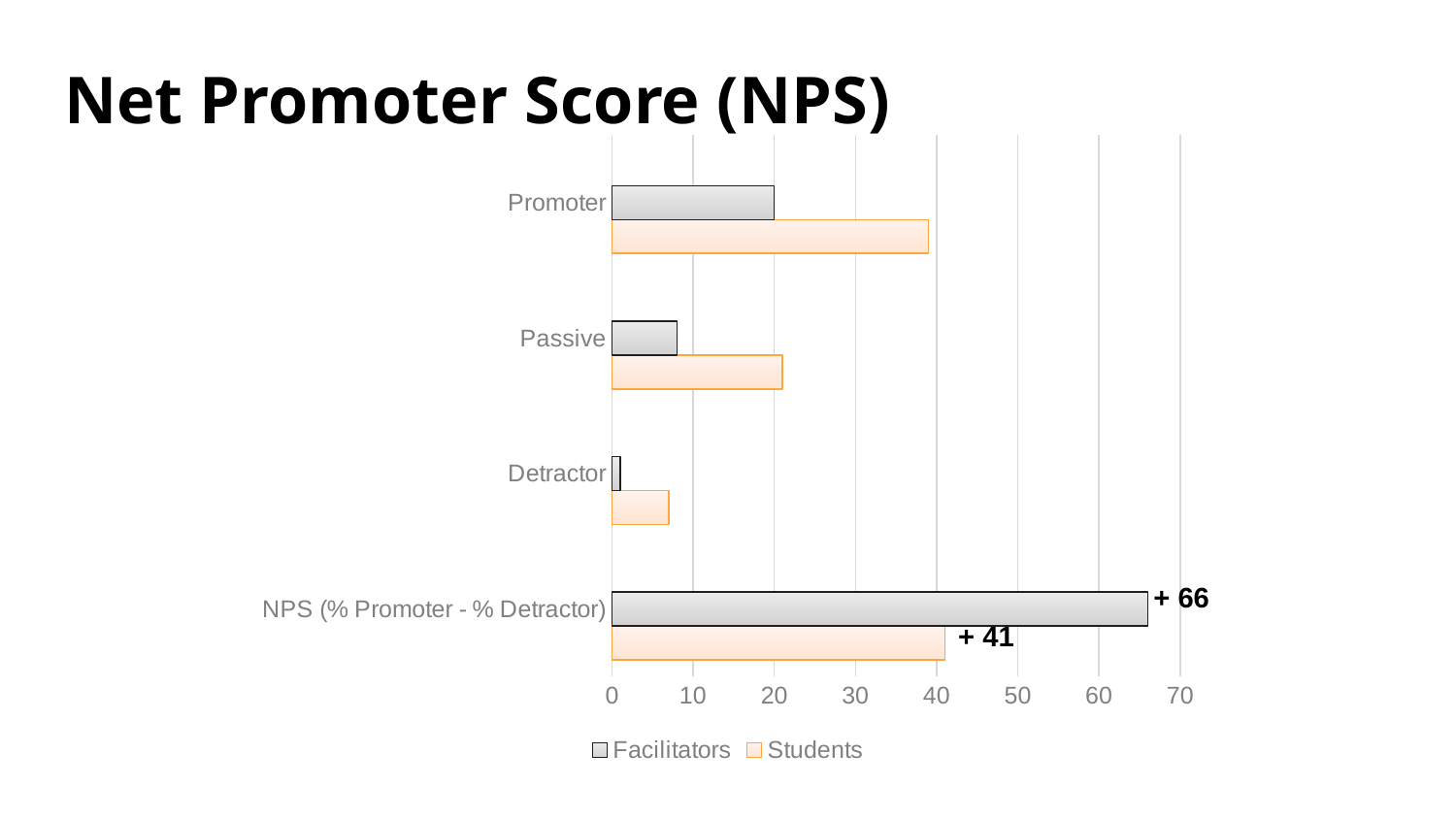
What is the difference between the Facilitators NPS and the Students NPS? 25 What is the NPS value for Facilitators? + 66 What is the NPS value for Students? + 41 Which group has the higher NPS, Facilitators or Students? Facilitators Is the Promoter value for Students greater or less than 30? greater Which category has the lowest value for Facilitators? Detractor How many series does the legend list? 2 Which category has the highest value for Students? NPS (% Promoter - % Detractor) Is the Promoter value for Facilitators greater or less than 30? less Is the Passive value for Students greater or less than 10? greater How many categories are shown on the chart? 4 What type of chart is shown on the slide? Bar chart